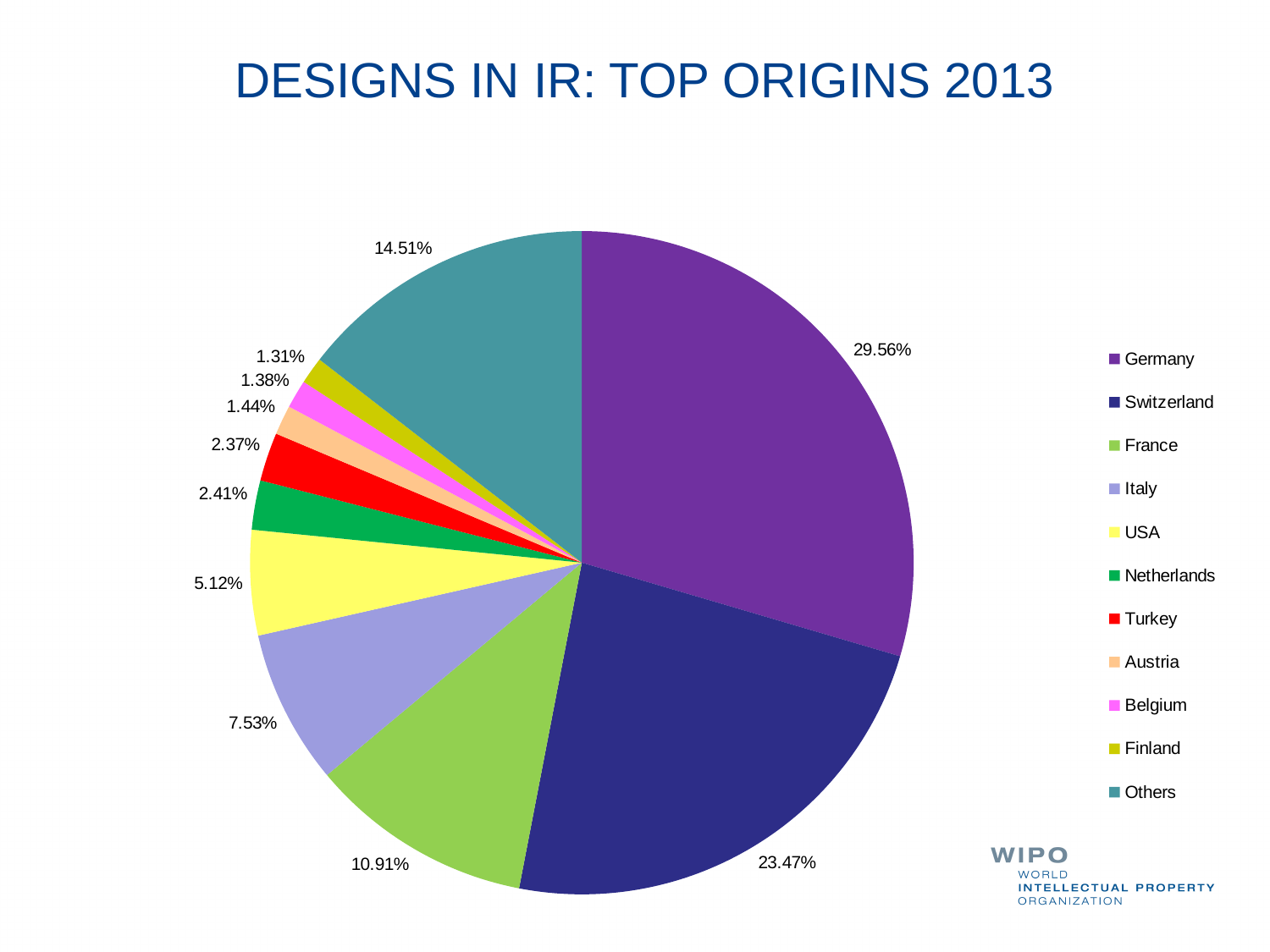
How many slices does the pie chart have? 11 What is the title of the chart? DESIGNS IN IR: TOP ORIGINS 2013 What is the value shown for Italy? 7.53% What share of the pie does Germany hold? 29.56% What kind of chart is shown on the slide? Pie chart What is the difference between the shares of Germany and Switzerland? 6.09% Which origin has the smallest slice of the pie? Finland Which is larger, the share for France or the share for USA? France What is the value shown for the Others slice? 14.51% Which origin has the largest slice of the pie? Germany How many entries does the legend list? 11 What is the value shown for Switzerland? 23.47%